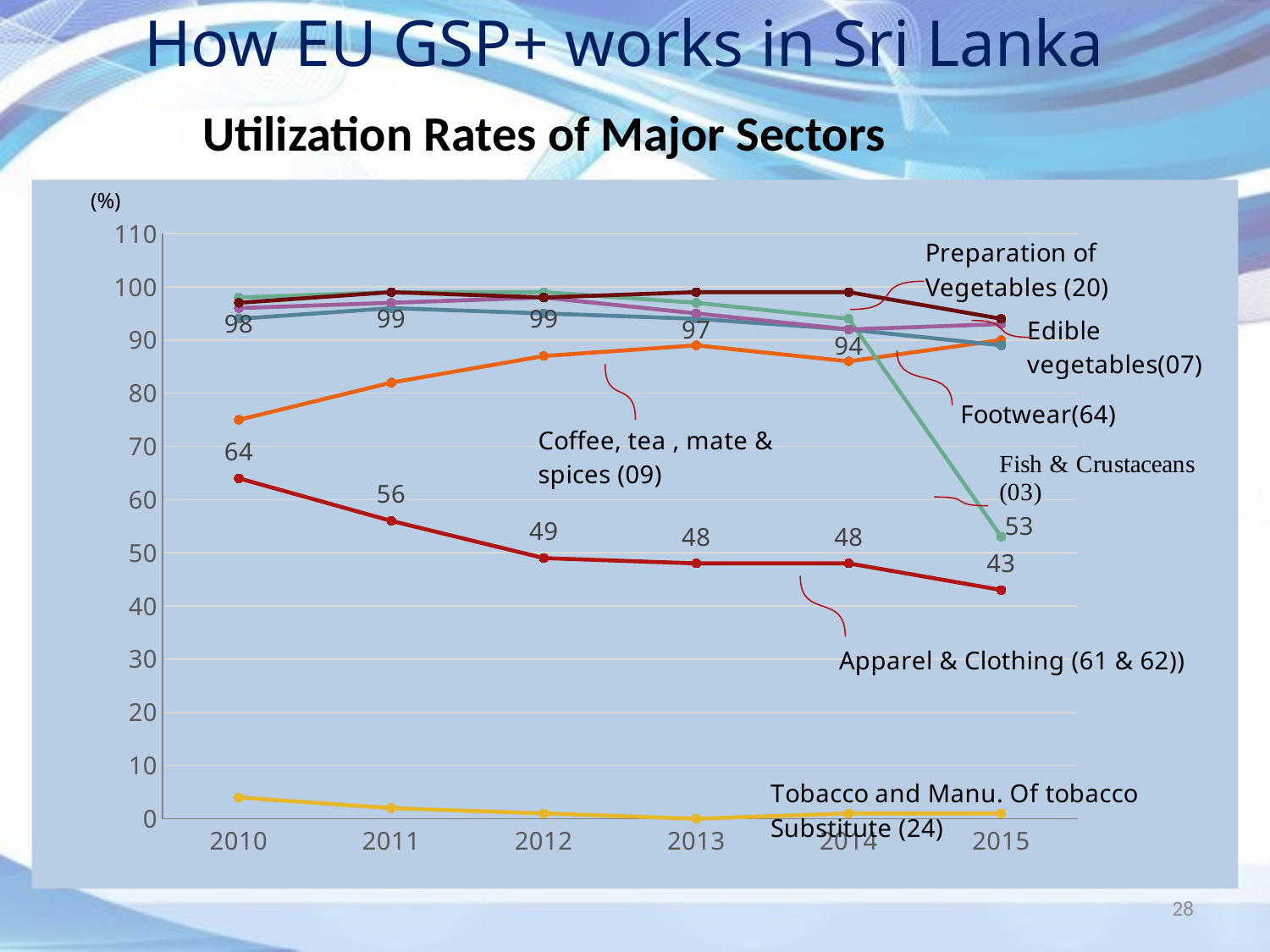
Does the Apparel & Clothing (61 & 62) line rise or fall from 2010 to 2015? fall By how much did the Apparel & Clothing (61 & 62) utilization rate fall from 2010 to 2015? 21 What is the utilization rate for Apparel & Clothing (61 & 62) in 2015? 43 Which sector has the lowest utilization rate in 2015? Tobacco and Manu. Of tobacco Substitute (24) What kind of chart is shown on the slide? line chart Is the value for Coffee, tea, mate & spices (09) in 2010 greater or less than 80? less Is the value for Coffee, tea, mate & spices (09) in 2013 greater or less than 80? greater What is the utilization rate for Apparel & Clothing (61 & 62) in 2010? 64 What is the utilization rate for Fish & Crustaceans (03) in 2015? 53 Which year has a higher Apparel & Clothing (61 & 62) utilization rate, 2011 or 2012? 2011 What unit is shown on the y axis of the chart? (%) How many years are shown on the x axis? 6